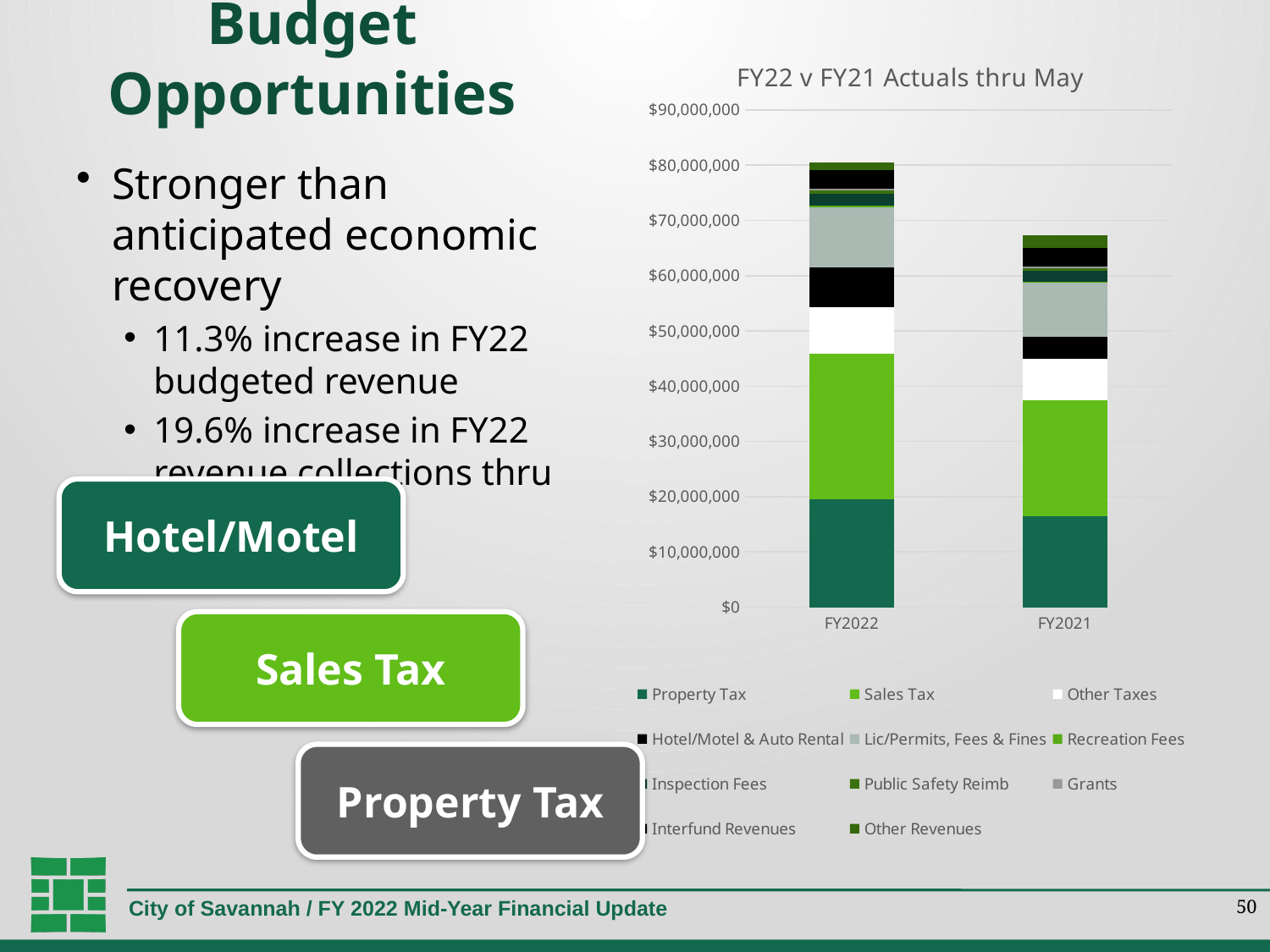
What kind of chart is shown on the slide? Stacked bar chart How many series does the chart's legend list? 11 Is the Sales Tax segment for FY2022 greater or less than $20,000,000? greater Is the total height of the FY2021 bar greater or less than $70,000,000? less How many fiscal years (bars) are plotted on the x axis of the chart? 2 What is the title of the chart? FY22 v FY21 Actuals thru May Which bar is taller overall, FY2022 or FY2021? FY2022 Which series is listed first in the chart's legend? Property Tax Do the total bar heights rise or fall moving from FY2022 to FY2021 along the x axis? fall Which bar has the highest total, FY2022 or FY2021? FY2022 Is the Property Tax segment for FY2021 greater or less than $20,000,000? less